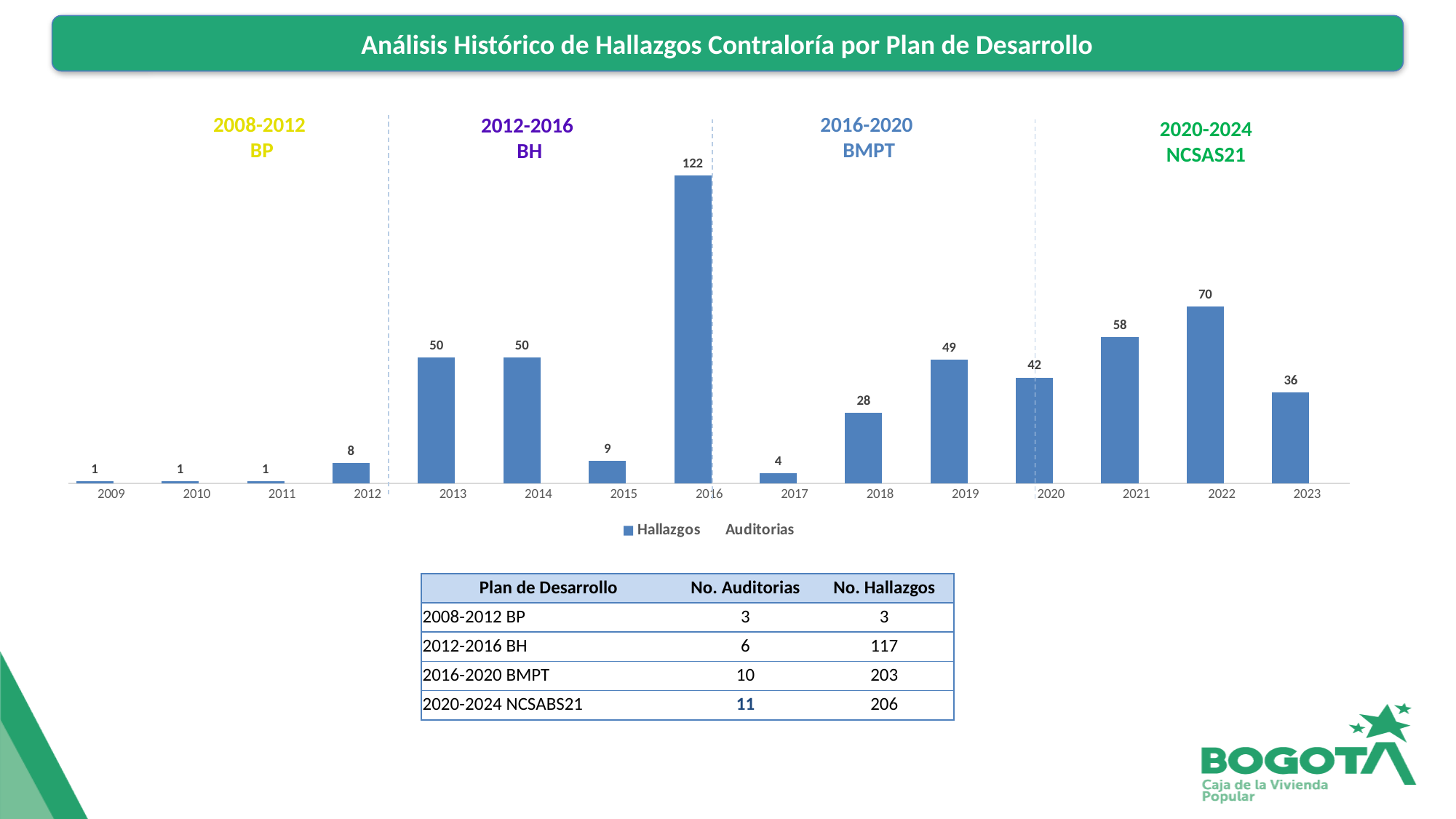
What is the value of Hallazgos for 2022? 70 Do the Hallazgos values rise or fall from 2020 to 2022? Rise What is the value of Hallazgos for 2018? 28 Which year has more Hallazgos, 2015 or 2017? 2015 What is the difference in Hallazgos between 2016 and 2013? 72 How many series does the chart legend list? 2 Which year has more Hallazgos, 2019 or 2020? 2019 What type of chart is shown on the slide? Bar chart How many years are shown on the x axis of the chart? 15 What is the value of Hallazgos for 2016? 122 Which year has the highest number of Hallazgos? 2016 What is the difference in Hallazgos between 2022 and 2023? 34